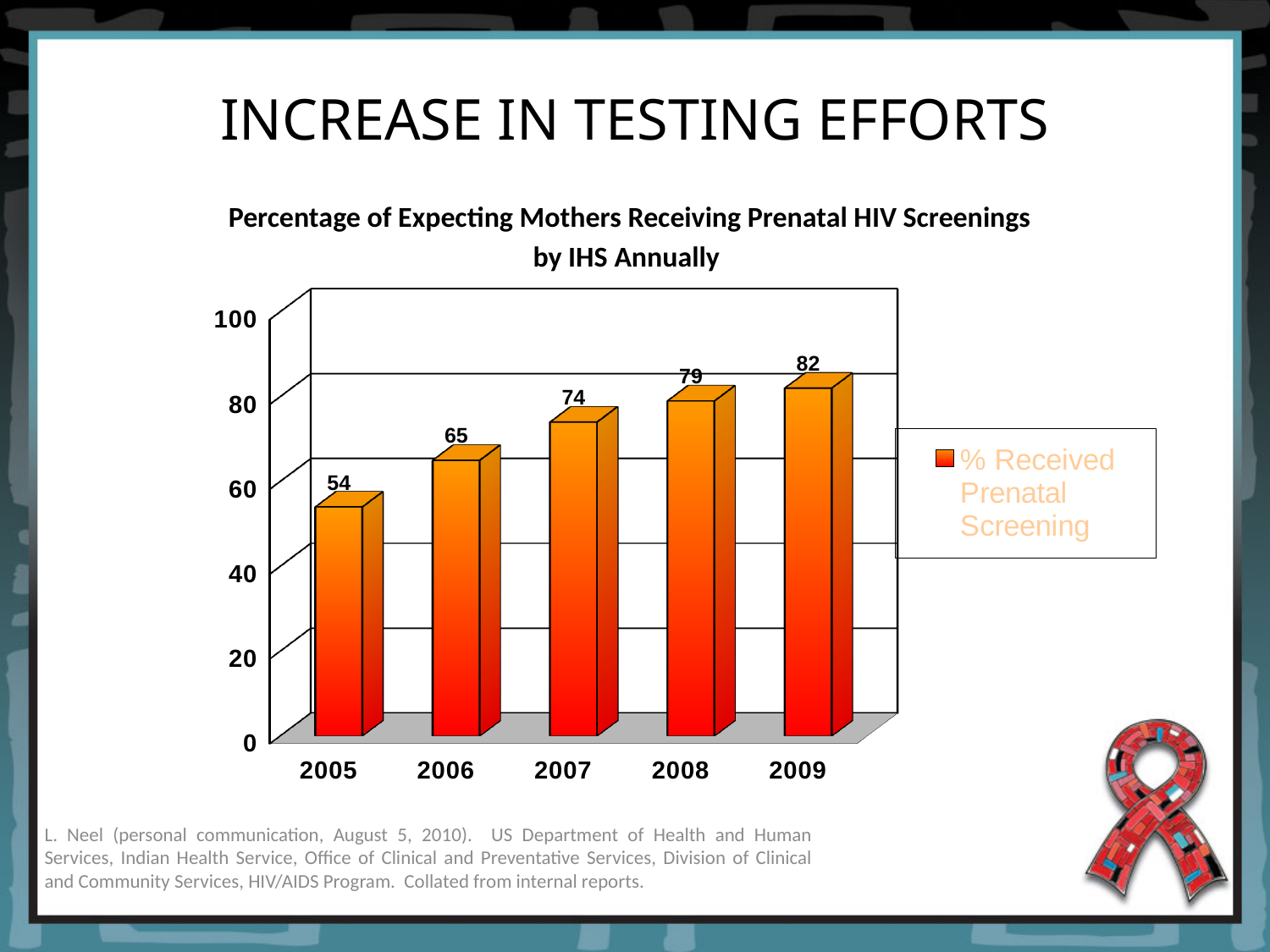
Which year has the highest value? 2009 What kind of chart is shown? bar chart What is the value for 2005? 54 What is the value for 2007? 74 What is the difference between the values for 2009 and 2005? 28 Do the values rise or fall from 2005 to 2009? rise How many series does the legend list? 1 Which is larger, the value for 2008 or the value for 2006? 2008 What is the value for 2009? 82 How many years are shown on the x axis? 5 What is the difference between the values for 2006 and 2005? 11 Which year has the lowest value? 2005